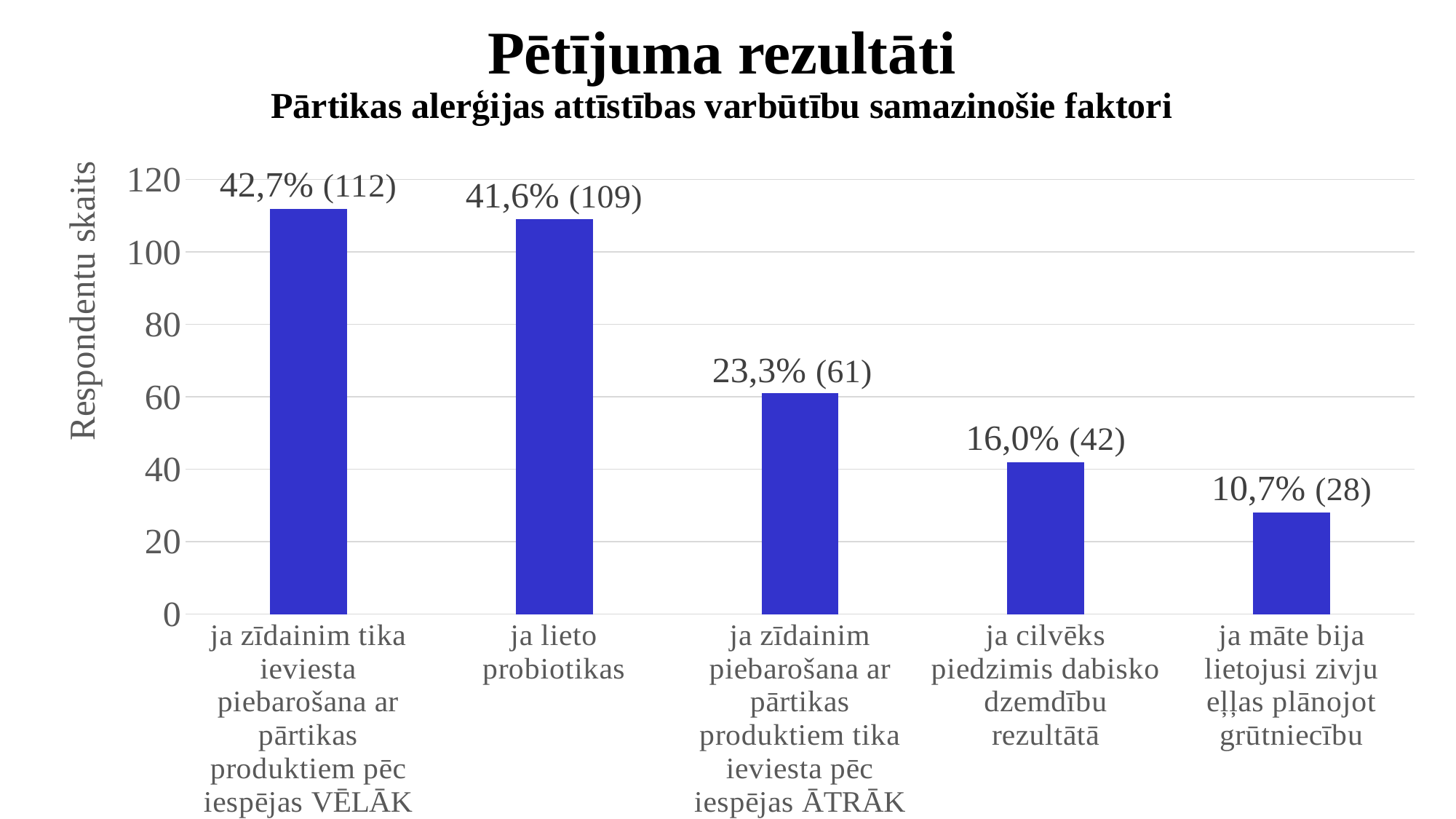
Which category has the highest number of respondents? ja zīdainim tika ieviesta piebarošana ar pārtikas produktiem pēc iespējas VĒLĀK What is the label of the vertical axis? Respondentu skaits What is the difference in respondent count between "ja zīdainim piebarošana ar pārtikas produktiem tika ieviesta pēc iespējas ĀTRĀK" and "ja cilvēks piedzimis dabisko dzemdību rezultātā"? 19 Which has more respondents: "ja cilvēks piedzimis dabisko dzemdību rezultātā" or "ja māte bija lietojusi zivju eļļas plānojot grūtniecību"? ja cilvēks piedzimis dabisko dzemdību rezultātā Is the value for "ja zīdainim piebarošana ar pārtikas produktiem tika ieviesta pēc iespējas ĀTRĀK" greater or less than 80? less How many categories are shown in the chart? 5 Which category has the lowest number of respondents? ja māte bija lietojusi zivju eļļas plānojot grūtniecību What is the data label shown for the bar "ja lieto probiotikas"? 41,6% (109) How many respondents are shown for "ja cilvēks piedzimis dabisko dzemdību rezultātā"? 42 What percentage is shown for "ja māte bija lietojusi zivju eļļas plānojot grūtniecību"? 10,7% What is the difference in respondent count between "ja zīdainim tika ieviesta piebarošana ar pārtikas produktiem pēc iespējas VĒLĀK" and "ja lieto probiotikas"? 3 What kind of chart is shown on the slide? bar chart